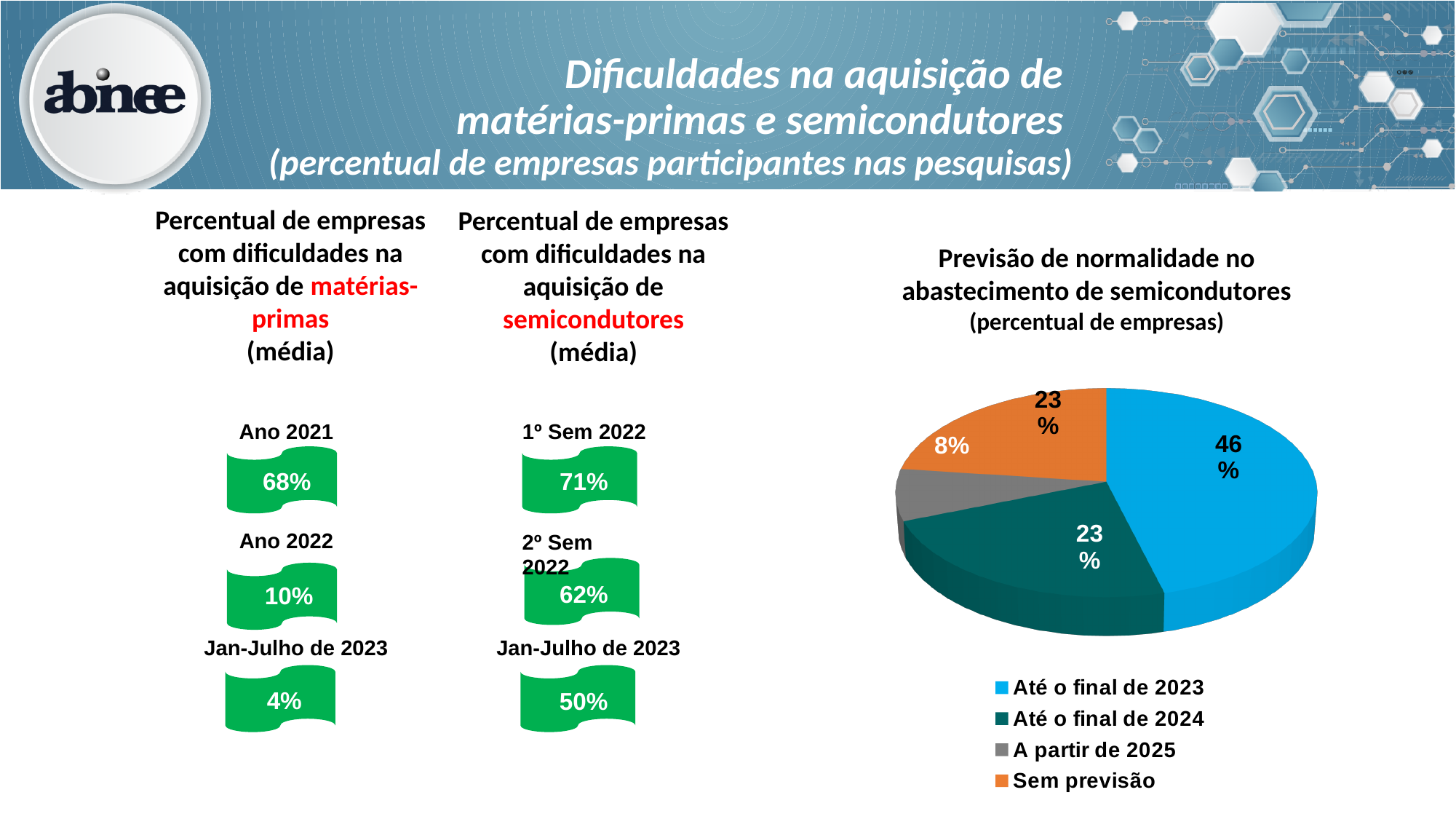
In the pie chart 'Previsão de normalidade no abastecimento de semicondutores', which category has the largest slice? Até o final de 2023 In the pie chart 'Previsão de normalidade no abastecimento de semicondutores', what colour is the 'Sem previsão' slice? Orange In the pie chart 'Previsão de normalidade no abastecimento de semicondutores', what percentage of companies expect normality 'Até o final de 2023'? 46% In the pie chart 'Previsão de normalidade no abastecimento de semicondutores', which category has the smallest slice? A partir de 2025 How many slices does the pie chart 'Previsão de normalidade no abastecimento de semicondutores' have? 4 In the pie chart 'Previsão de normalidade no abastecimento de semicondutores', what percentage corresponds to 'A partir de 2025'? 8% In the left panel 'Percentual de empresas com dificuldades na aquisição de matérias-primas (média)', what is the value for 'Jan-Julho de 2023'? 4% In the pie chart 'Previsão de normalidade no abastecimento de semicondutores', which is larger: 'Até o final de 2023' or 'Até o final de 2024'? Até o final de 2023 How many entries does the legend of the pie chart 'Previsão de normalidade no abastecimento de semicondutores' list? 4 In the pie chart 'Previsão de normalidade no abastecimento de semicondutores', what is the difference in percentage points between 'Até o final de 2023' and 'A partir de 2025'? 38 percentage points In the pie chart 'Previsão de normalidade no abastecimento de semicondutores', what percentage corresponds to 'Sem previsão'? 23% What kind of chart is 'Previsão de normalidade no abastecimento de semicondutores'? Pie chart